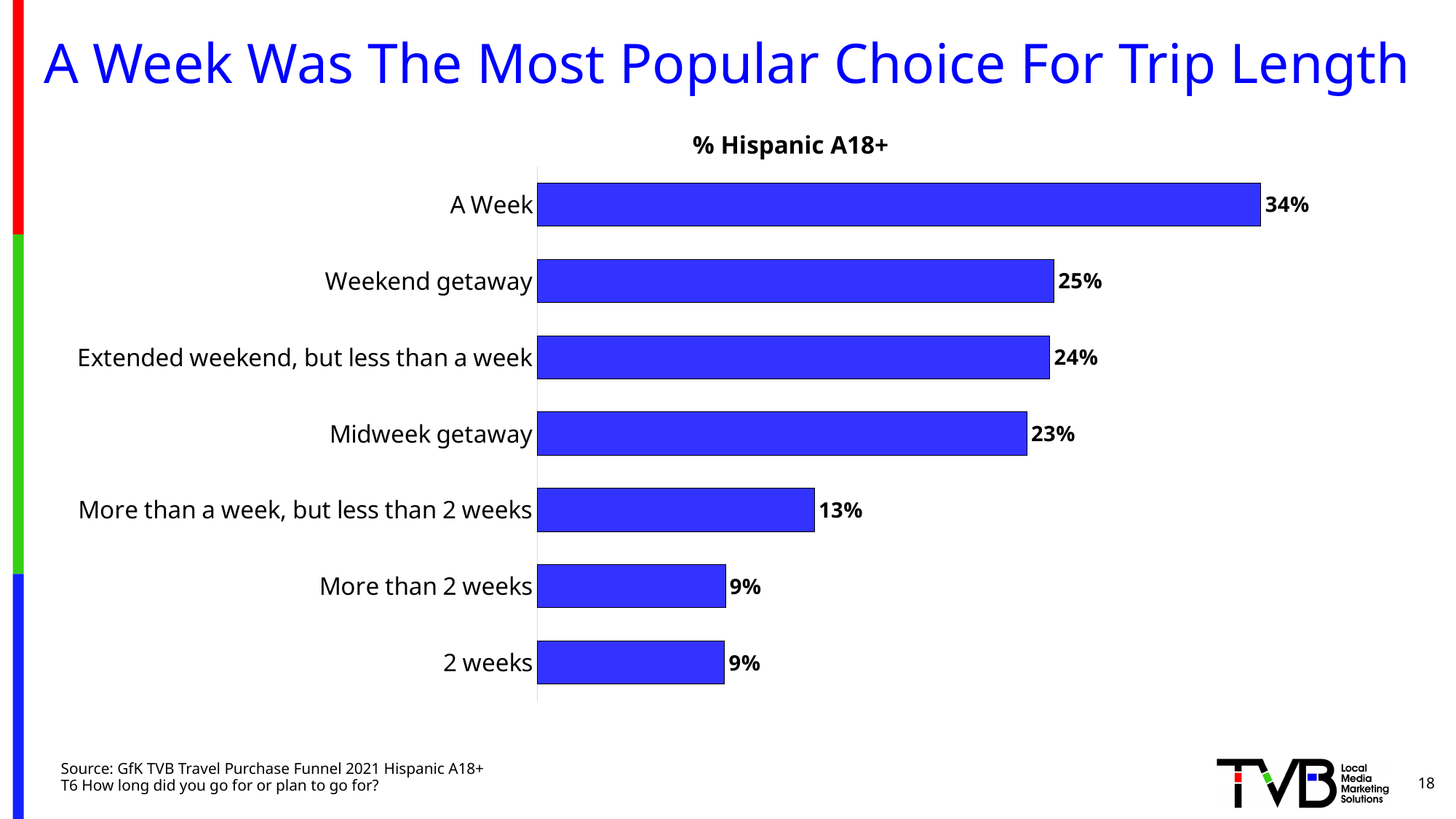
Which category has the highest value? A Week What colour are the bars in the chart? Blue What is the difference between the values for Extended weekend, but less than a week and More than 2 weeks? 15% What is the title of the chart? % Hispanic A18+ What is the value for A Week? 34% How many categories are shown in the chart? 7 Which is larger, the value for Weekend getaway or the value for Midweek getaway? Weekend getaway What is the value for 2 weeks? 9% What kind of chart is shown on the slide? Bar chart What is the value for More than a week, but less than 2 weeks? 13% What is the difference between the values for A Week and Weekend getaway? 9% What is the value for Midweek getaway? 23%